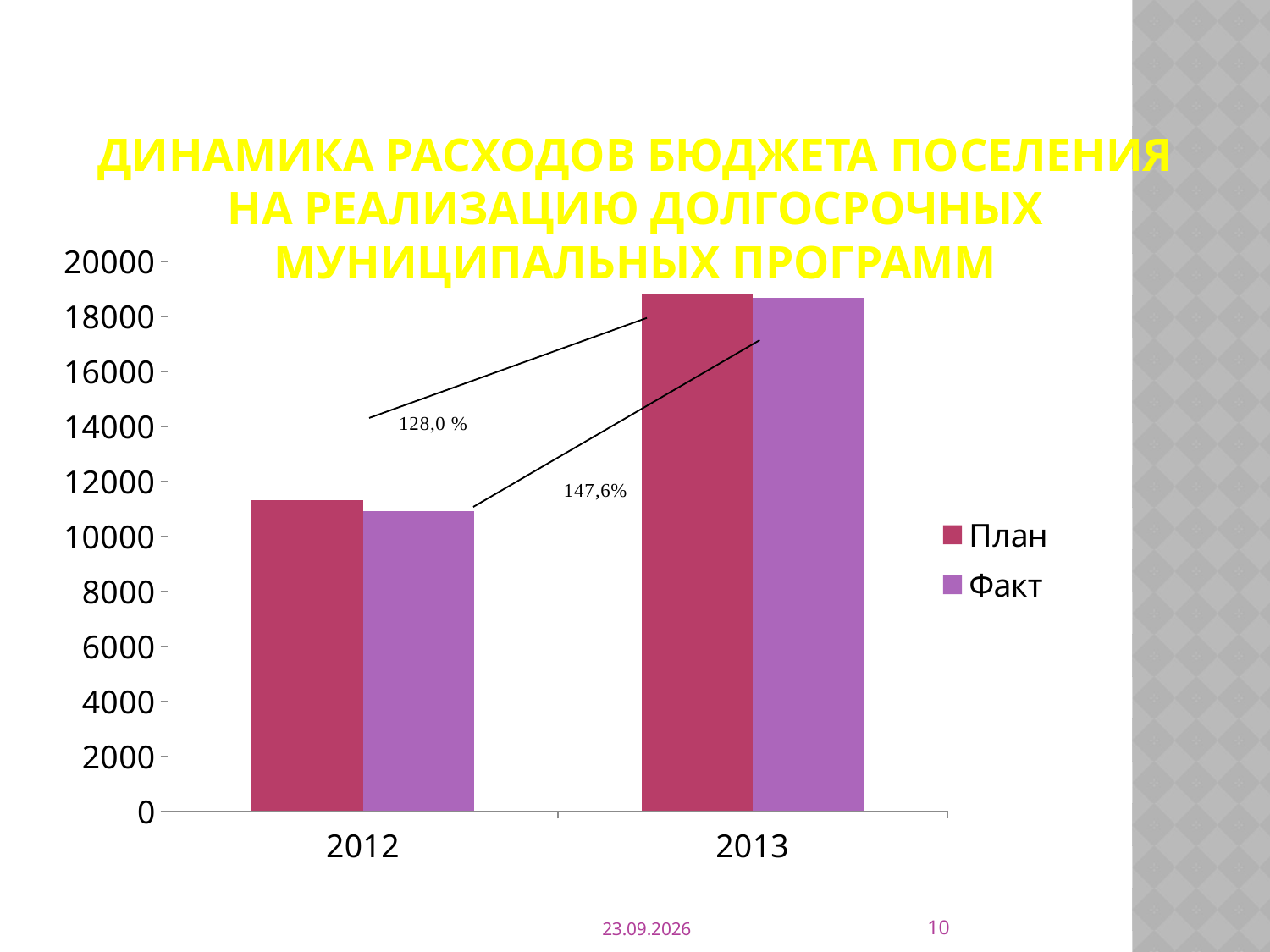
Which series are listed in the legend? План, Факт Do the values rise or fall from 2012 to 2013? rise Is the value for План in 2012 greater or less than 10000? greater Is the value for Факт in 2012 greater or less than 12000? less How many series does the legend list? 2 Which is larger, the Факт value for 2012 or the Факт value for 2013? 2013 What kind of chart is shown on the slide? bar chart How many categories are shown on the x axis? 2 What percentage is written next to the arrow connecting the План bars? 128,0 % Is the value for Факт in 2013 greater or less than 16000? greater Which is larger, the План value for 2012 or the План value for 2013? 2013